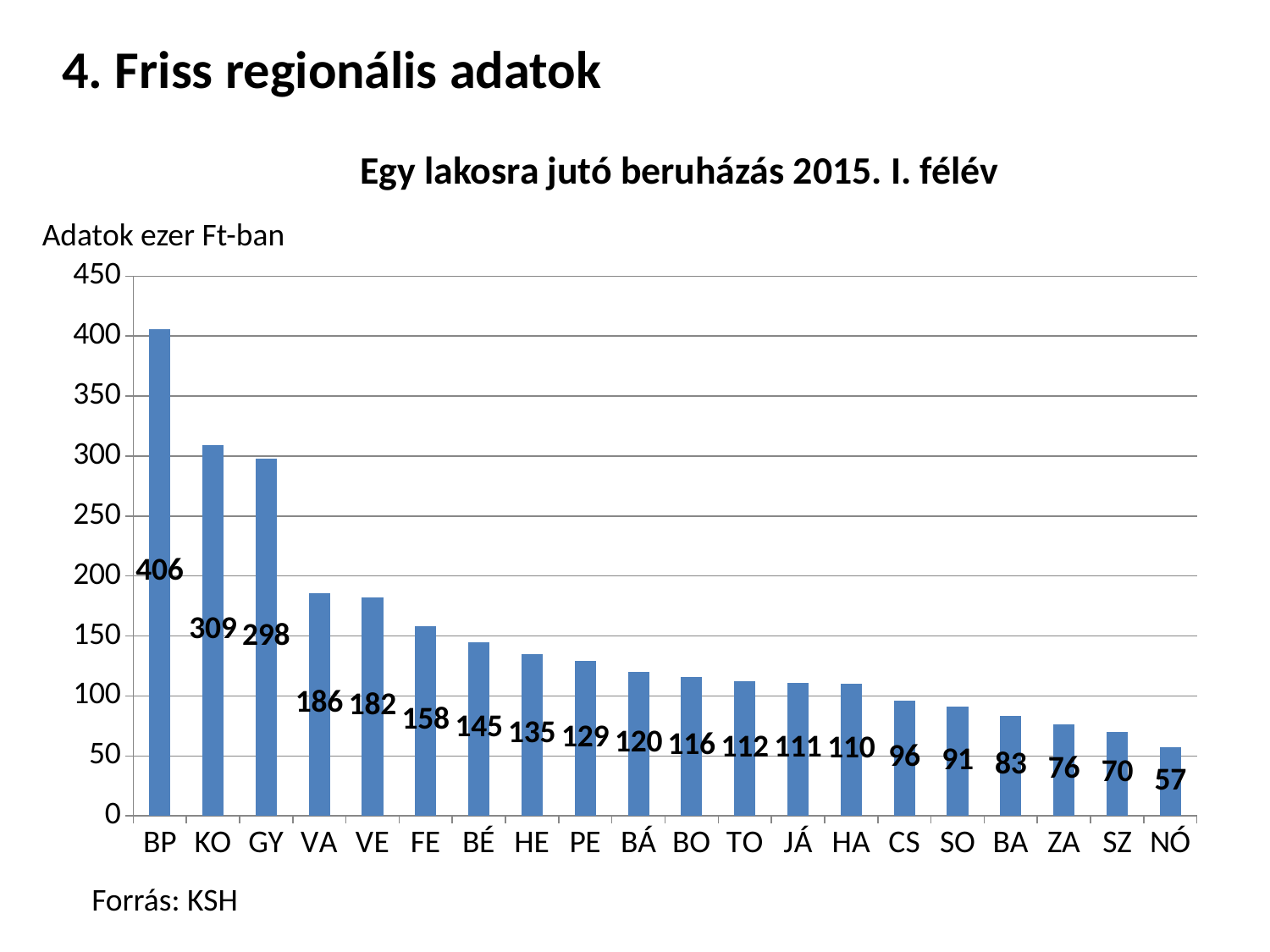
Which category has the lowest value? NÓ Which is larger, the value for VA or the value for HE? VA How many categories are shown on the x axis? 20 What kind of chart is shown on the slide? bar chart What is the difference between the values for KO and GY? 11 What is the value for FE? 158 What is the value for CS? 96 What is the title of the chart? Egy lakosra jutó beruházás 2015. I. félév Is the value for BÁ greater or less than 100? greater What is the value for BP? 406 Which category has the highest value? BP What is the difference between the values for BP and NÓ? 349